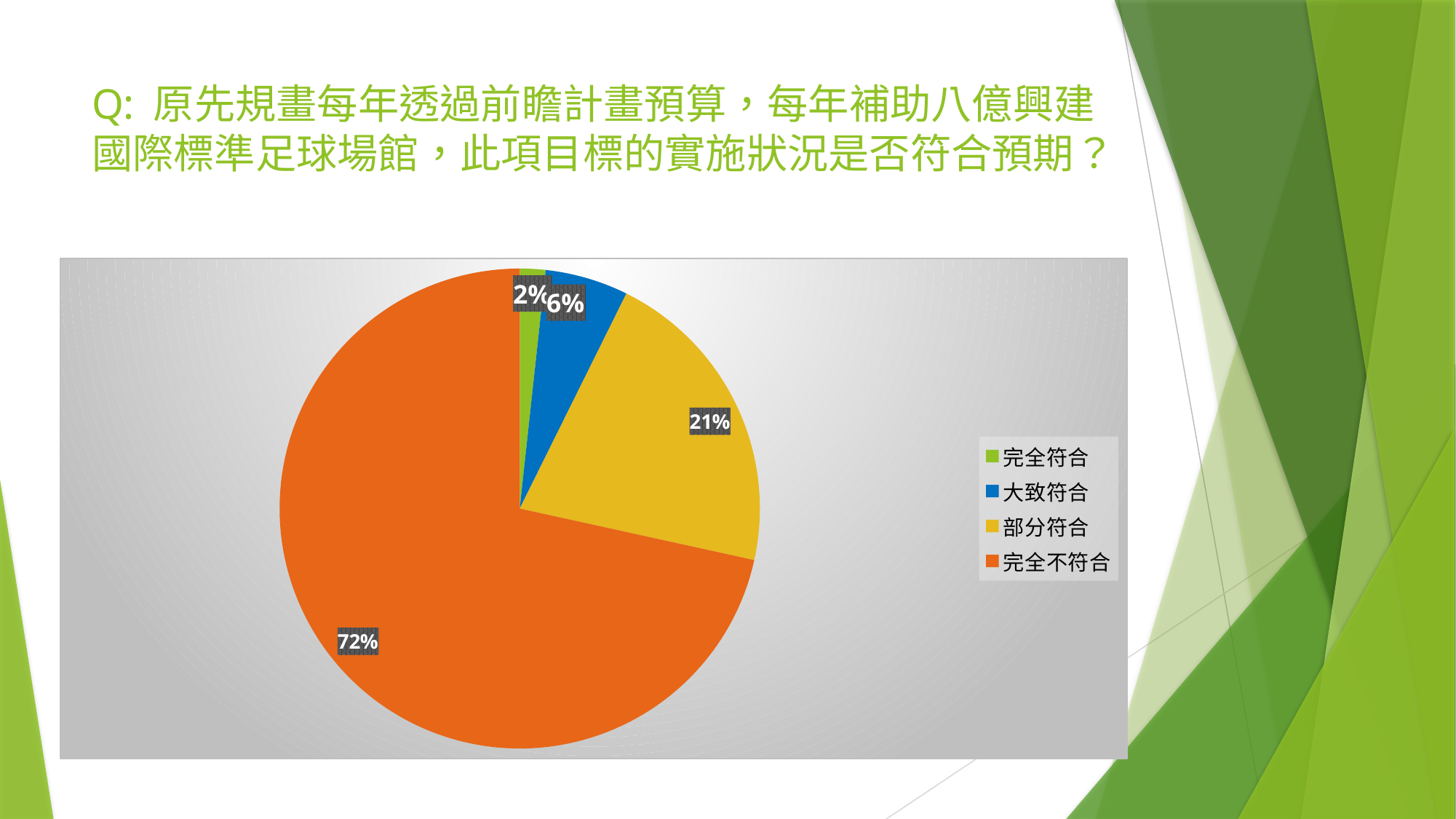
What is the difference in percentage points between 完全不符合 and 部分符合? 51 Which is larger, the slice for 部分符合 or the slice for 大致符合? 部分符合 Which category has the largest slice of the pie? 完全不符合 What share of the pie does 大致符合 take? 6% How many categories does the pie chart have? 4 What kind of chart is shown on the slide? pie chart What share of the pie does 部分符合 take? 21% Which category has the smallest slice of the pie? 完全符合 What share of the pie does 完全不符合 take? 72% What colour is the slice for 完全不符合? orange What is the difference in percentage points between 大致符合 and 完全符合? 4